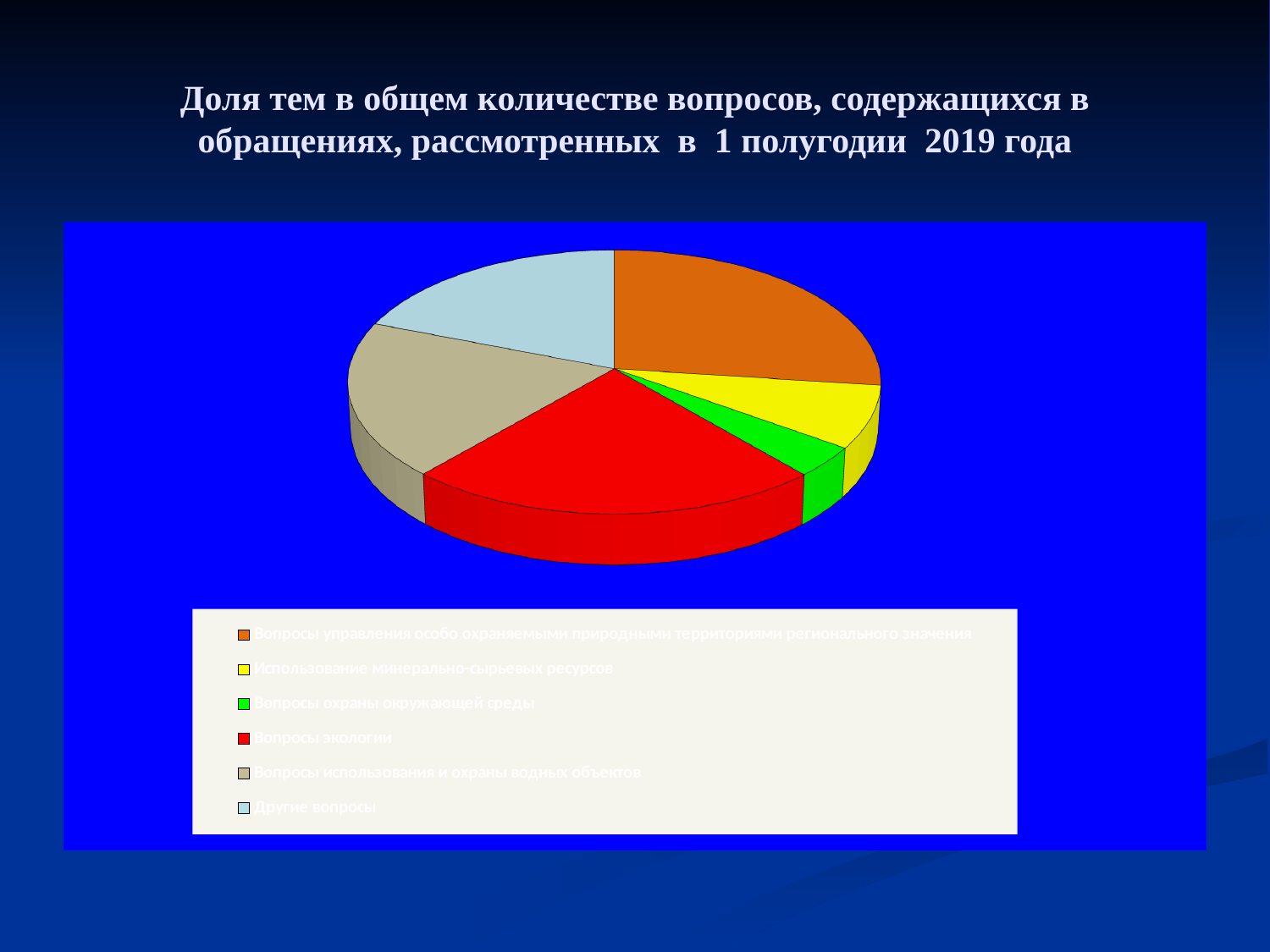
What is the title of the slide? Доля тем в общем количестве вопросов, содержащихся в обращениях, рассмотренных в 1 полугодии 2019 года How many entries does the legend list? 6 Which slice is larger: "Вопросы использования и охраны водных объектов" or "Вопросы охраны окружающей среды"? Вопросы использования и охраны водных объектов How many categories (slices) does the pie chart have? 6 Which slice is larger: "Вопросы управления особо охраняемыми природными территориями регионального значения" or "Использование минерально-сырьевых ресурсов"? Вопросы управления особо охраняемыми природными территориями регионального значения Which slice is larger: "Вопросы экологии" or "Вопросы охраны окружающей среды"? Вопросы экологии Which colour represents "Вопросы экологии" in the pie chart? red What kind of chart is shown on the slide? pie chart Which category has the smallest slice of the pie? Вопросы охраны окружающей среды